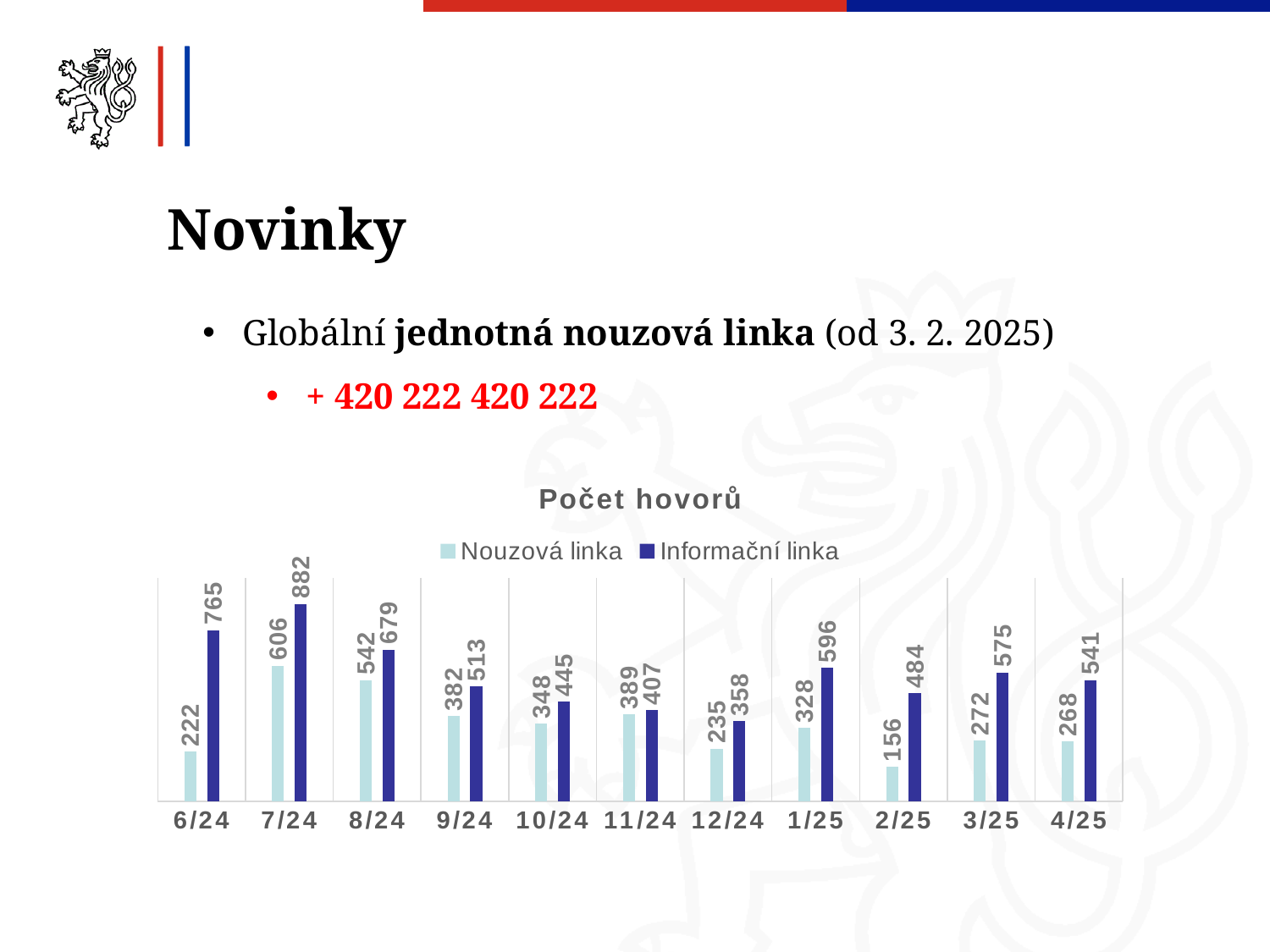
What is the value for Nouzová linka in 12/24? 235 Which month has the lowest value for Nouzová linka? 2/25 How many series does the legend list? 2 What kind of chart is shown on the slide? bar chart What is the value for Nouzová linka in 7/24? 606 What is the difference between Informační linka and Nouzová linka in 6/24? 543 Which is larger in 11/24: Nouzová linka or Informační linka? Informační linka What is the title of the chart? Počet hovorů How many months are shown on the x axis? 11 What is the difference between Nouzová linka in 7/24 and Nouzová linka in 8/24? 64 Which month has the highest value for Informační linka? 7/24 What is the value for Informační linka in 2/25? 484